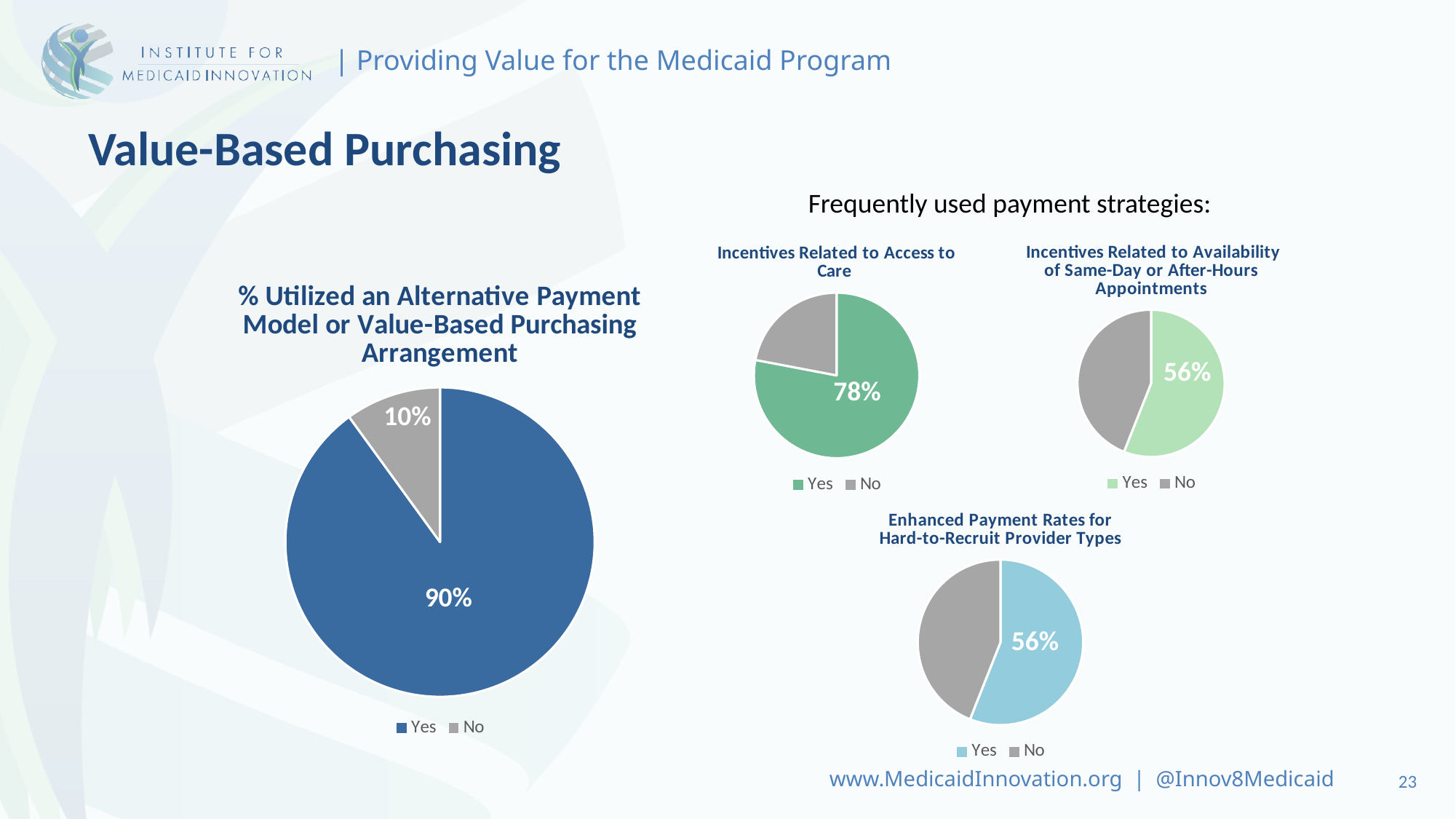
What type of chart is used for '% Utilized an Alternative Payment Model or Value-Based Purchasing Arrangement'? Pie chart Is the Yes share in the 'Incentives Related to Access to Care' chart larger or smaller than the Yes share in the 'Enhanced Payment Rates for Hard-to-Recruit Provider Types' chart? Larger In the pie chart titled '% Utilized an Alternative Payment Model or Value-Based Purchasing Arrangement', which slice is larger, Yes or No? Yes How many pie charts are shown on the slide? 4 In the pie chart titled 'Enhanced Payment Rates for Hard-to-Recruit Provider Types', what percentage answered Yes? 56% How many entries does the legend of the 'Incentives Related to Access to Care' pie chart list? 2 In the pie chart titled 'Incentives Related to Access to Care', what percentage answered Yes? 78% In the pie chart titled '% Utilized an Alternative Payment Model or Value-Based Purchasing Arrangement', what percentage answered No? 10% Which payment strategy pie chart has the largest Yes share: 'Incentives Related to Access to Care', 'Incentives Related to Availability of Same-Day or After-Hours Appointments', or 'Enhanced Payment Rates for Hard-to-Recruit Provider Types'? Incentives Related to Access to Care In the pie chart titled '% Utilized an Alternative Payment Model or Value-Based Purchasing Arrangement', what is the difference in percentage points between the Yes and No slices? 80 percentage points In the pie chart titled '% Utilized an Alternative Payment Model or Value-Based Purchasing Arrangement', what percentage answered Yes? 90% In the pie chart titled 'Incentives Related to Availability of Same-Day or After-Hours Appointments', what percentage answered Yes? 56%